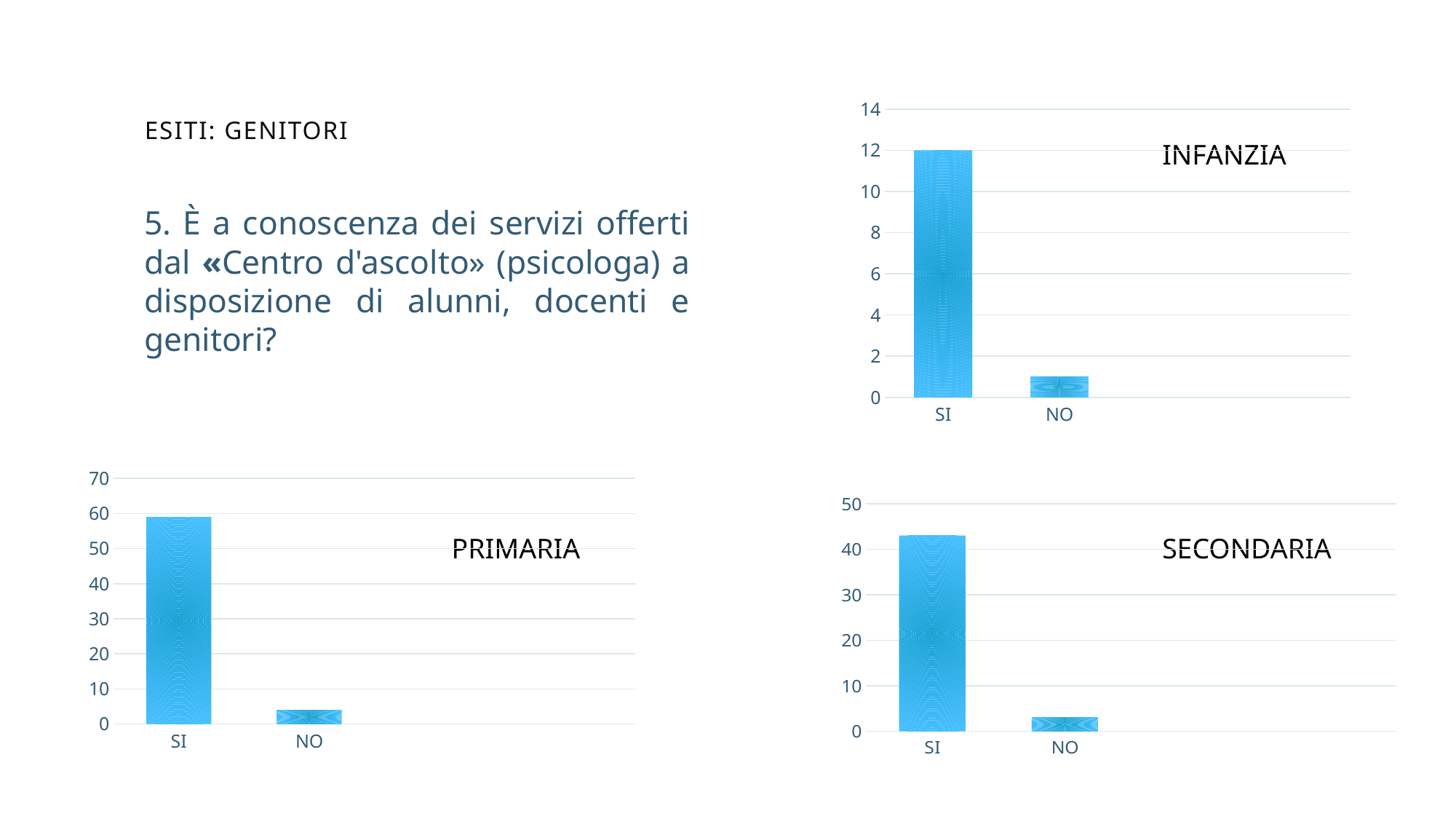
In the SECONDARIA chart, which is larger, SI or NO? SI How many charts are shown on the slide? 3 In the SECONDARIA chart, is the value for NO greater or less than 10? less In the INFANZIA chart, which category has the highest value? SI In the PRIMARIA chart, which category has the lowest value? NO How many categories are shown in the PRIMARIA chart? 2 In the SECONDARIA chart, is the value for SI greater or less than 40? greater In the PRIMARIA chart, is the value for SI greater or less than 50? greater In the INFANZIA chart, what is the value for SI? 12 What kind of chart is the INFANZIA chart? bar chart